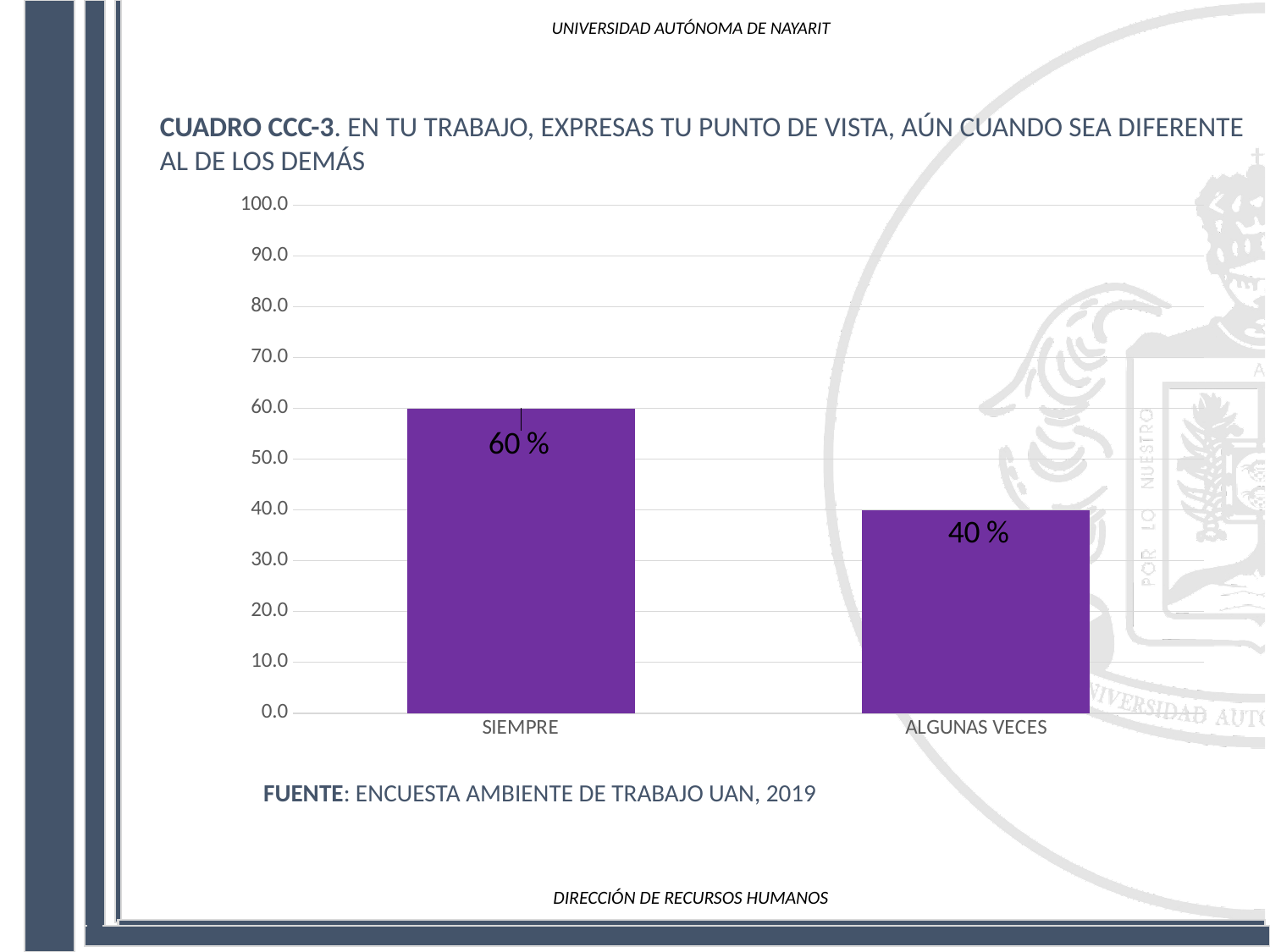
Which category has the highest value? SIEMPRE Which is larger, the value for SIEMPRE or the value for ALGUNAS VECES? SIEMPRE What is the difference between the values for SIEMPRE and ALGUNAS VECES? 20 % What is the value for SIEMPRE? 60 % What is the value for ALGUNAS VECES? 40 % What colour are the bars in the chart? purple How many categories are shown on the x axis? 2 Which category has the lowest value? ALGUNAS VECES Is the value for ALGUNAS VECES greater or less than 50.0? less What is the source cited below the chart? ENCUESTA AMBIENTE DE TRABAJO UAN, 2019 Is the value for SIEMPRE greater or less than 50.0? greater What kind of chart is shown on the slide? bar chart